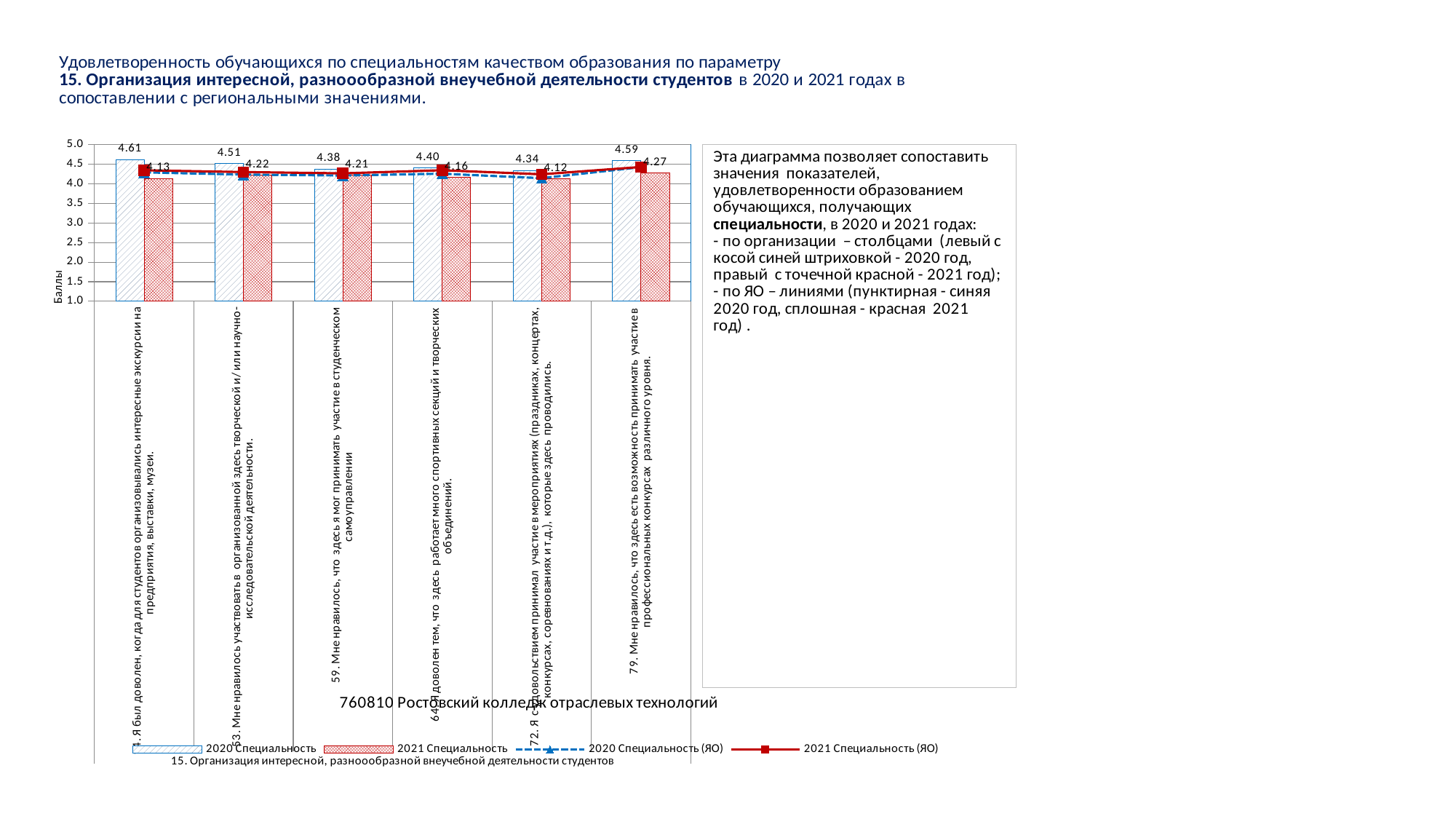
Which item has the highest 2020 Специальность value? 1. Я был доволен, когда для студентов организовывались интересные экскурсии на предприятия, выставки, музеи (4.61) What is the 2020 Специальность value for item 1 (Я был доволен, когда для студентов организовывались интересные экскурсии на предприятия, выставки, музеи)? 4.61 Which item has the lowest 2021 Специальность value? 72. Я с удовольствием принимал участие в мероприятиях (праздниках, концертах, конкурсах, соревнованиях и т.д.), которые здесь проводились (4.12) For item 59 (участие в студенческом самоуправлении), which is larger: the 2020 Специальность value or the 2021 Специальность value? 2020 Специальность (4.38) What kind of chart is shown on the slide? A combined bar and line chart What is the difference between the 2020 and 2021 Специальность values for item 1? 0.48 How many items (categories) are shown on the x axis of the chart? 6 How many series does the chart legend list? 4 Which item has the lowest 2020 Специальность value? 72. Я с удовольствием принимал участие в мероприятиях (праздниках, концертах, конкурсах, соревнованиях и т.д.), которые здесь проводились (4.34) What is the 2021 Специальность value for item 53 (Мне нравилось участвовать в организованной здесь творческой и/или научно-исследовательской деятельности)? 4.22 Is the 2021 Специальность value for item 72 greater or less than 4.0? greater What is the 2021 Специальность value for item 79 (Мне нравилось, что здесь есть возможность принимать участие в профессиональных конкурсах различного уровня)? 4.27